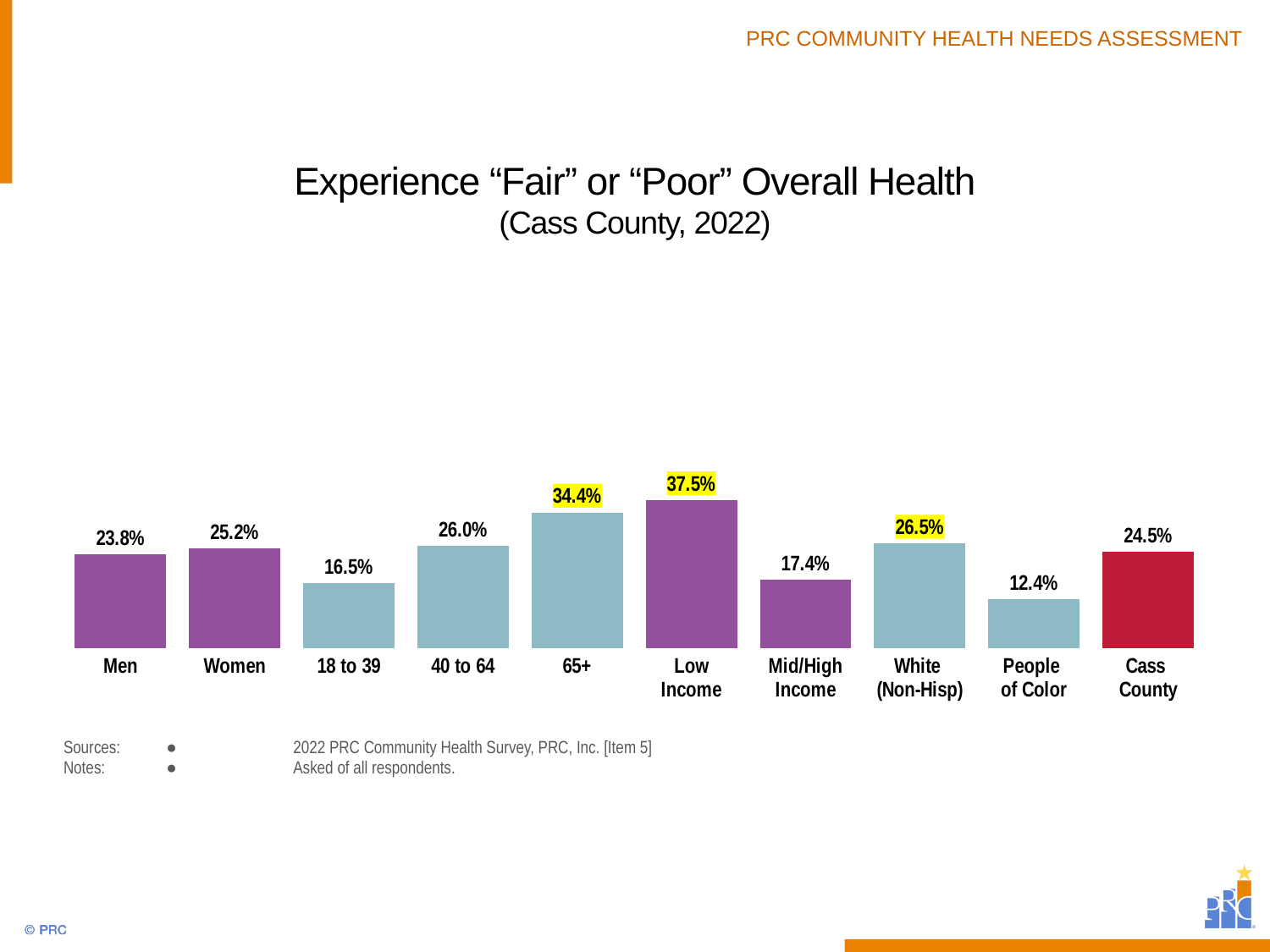
Which is larger, the value for 65+ or the value for 40 to 64? 65+ What is the value for Cass County overall? 24.5% Which category has the lowest value? People of Color What is the difference between the values for Women and Men? 1.4% Which category has the highest value? Low Income What is the value for People of Color? 12.4% How many categories are shown in the chart? 10 What is the value for Low Income? 37.5% What is the value for the 18 to 39 age group? 16.5% What kind of chart is shown on the slide? Bar chart What is the title of the chart? Experience "Fair" or "Poor" Overall Health (Cass County, 2022) What is the difference between the values for Low Income and Mid/High Income? 20.1%